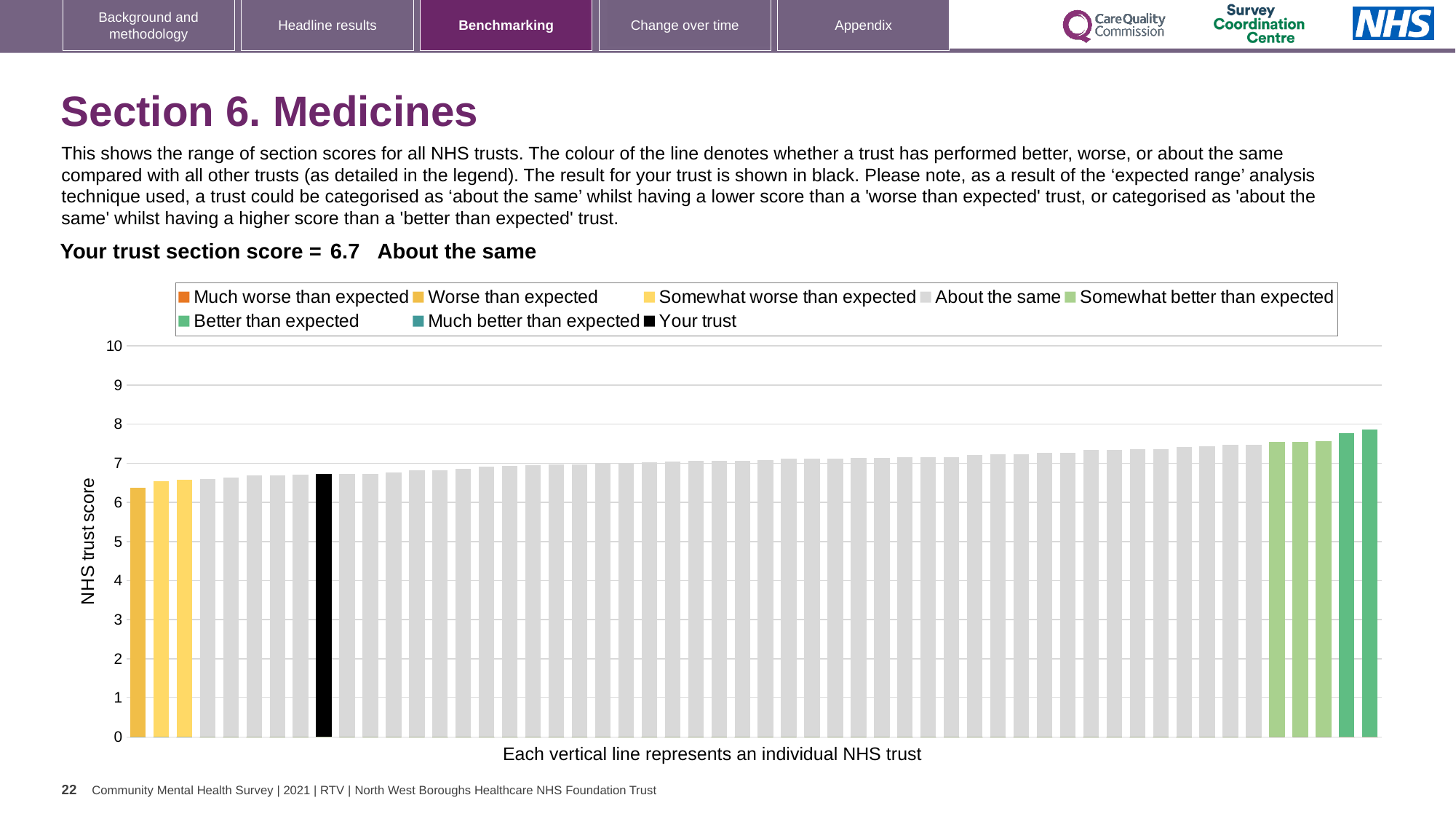
What kind of chart is shown on the slide? bar chart How many bars are coloured as 'Much better than expected'? 0 What colour is the bar representing your trust? black How many bars are coloured as 'Worse than expected'? 1 Is the value of the tallest bar in the chart greater or less than 8? less What is the trust's section score for Section 6. Medicines? 6.7 What is the label on the vertical axis of the chart? NHS trust score Do the bar values rise or fall from left to right along the x axis? rise How many entries does the chart legend list? 8 Is the value of the shortest bar in the chart greater or less than 7? less Which benchmarking category is the trust placed in for Section 6. Medicines? About the same Is the value for the trust's own bar (black) greater or less than 5? greater